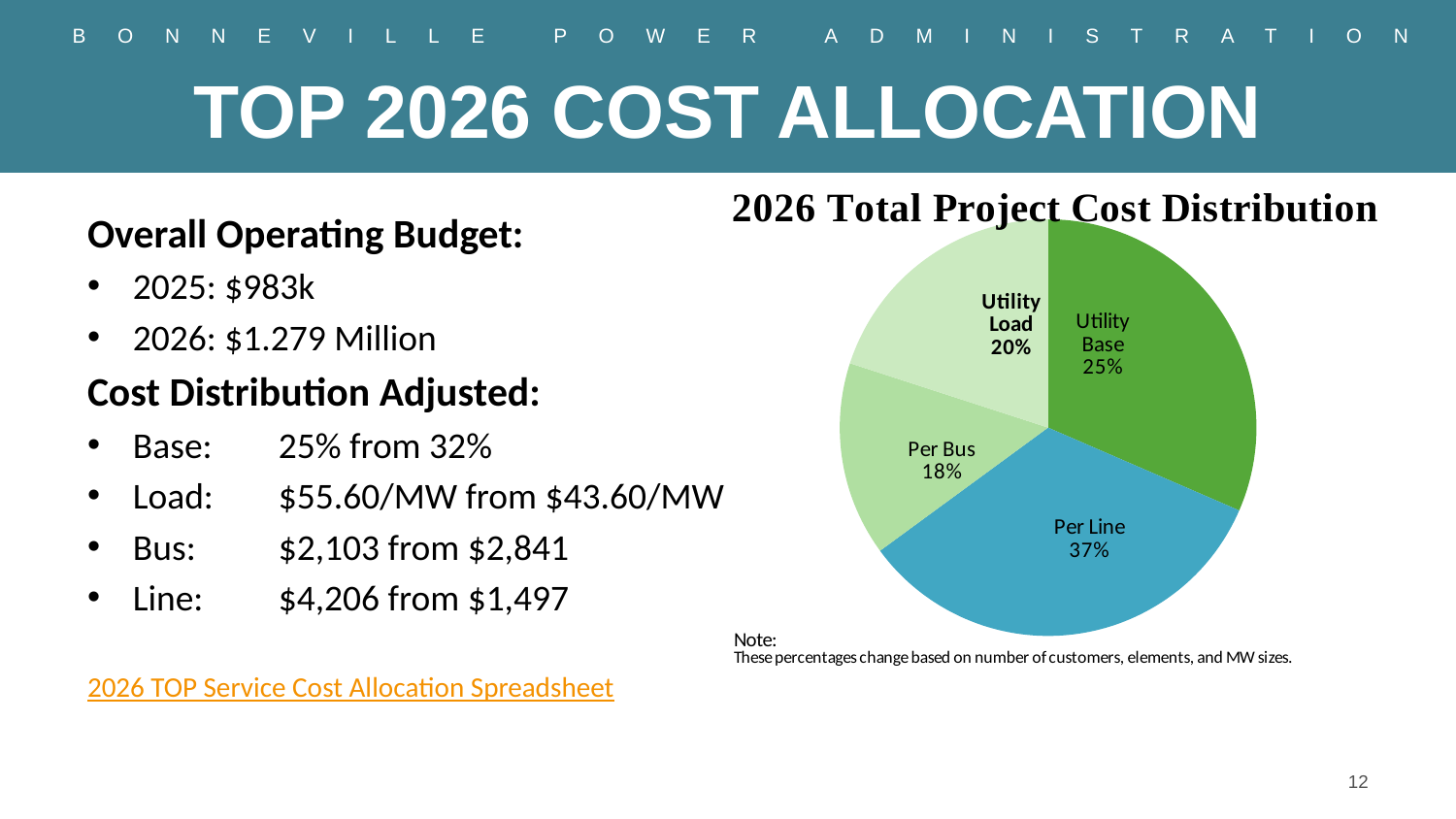
What is the combined share of Utility Base and Utility Load? 45% What share of the pie does Per Line represent? 37% What share of the pie does Utility Load represent? 20% What share of the pie does Per Bus represent? 18% Which is larger, the Utility Load slice or the Per Bus slice? Utility Load What is the difference in percentage points between Per Line and Utility Base? 12 What type of chart is shown on the slide? Pie chart How many slices does the pie chart have? 4 What is the title of the chart? 2026 Total Project Cost Distribution What share of the pie does Utility Base represent? 25% Which slice of the pie is the largest? Per Line Which slice of the pie is the smallest? Per Bus